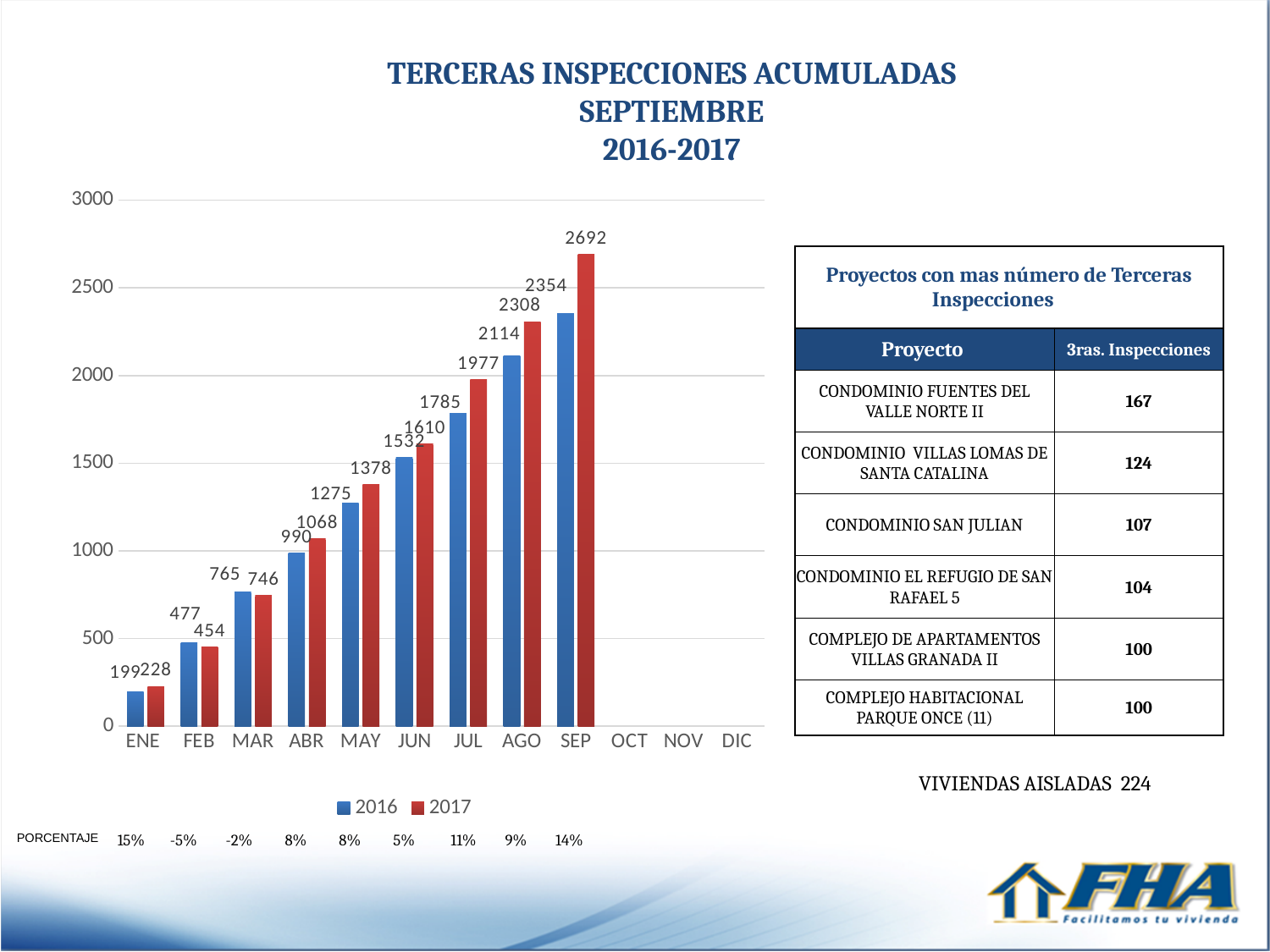
Do the 2017 values rise or fall from ENE to SEP? Rise What kind of chart is shown on the slide? Bar chart What is the value for 2017 in ENE? 228 What is the value for 2017 in SEP? 2692 Which is larger in AGO, the 2016 value or the 2017 value? 2017 What is the difference between the 2016 and 2017 values in FEB? 23 What is the value for 2016 in MAY? 1275 Which is larger in MAR, the 2016 value or the 2017 value? 2016 Which month has the highest value for the 2016 series? SEP How many series does the legend list? 2 What is the difference between the 2017 and 2016 values in SEP? 338 Which month has the lowest value for the 2017 series? ENE